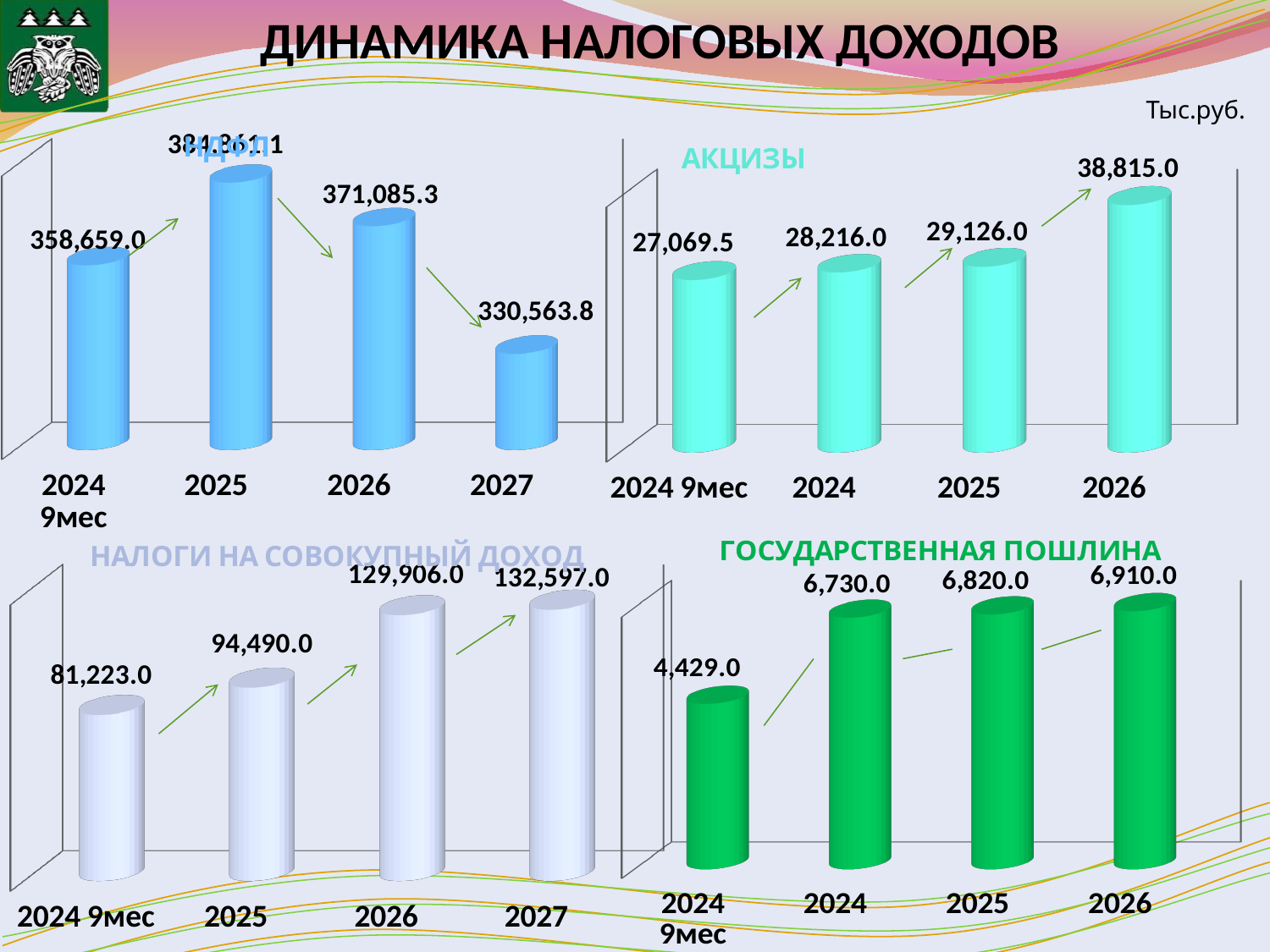
In the АКЦИЗЫ chart, what is the value for 2026? 38,815.0 In the ГОСУДАРСТВЕННАЯ ПОШЛИНА chart, what is the value for 2025? 6,820.0 In the НАЛОГИ НА СОВОКУПНЫЙ ДОХОД chart, what is the value for 2024 9мес? 81,223.0 What kind of chart is the ГОСУДАРСТВЕННАЯ ПОШЛИНА chart? bar chart In the НДФЛ chart, which is larger: the value for 2026 or the value for 2027? 2026 How many bars are in the АКЦИЗЫ chart? 4 In the НАЛОГИ НА СОВОКУПНЫЙ ДОХОД chart, do the values rise or fall from 2024 9мес to 2027? rise In the НАЛОГИ НА СОВОКУПНЫЙ ДОХОД chart, what is the difference between the values for 2026 and 2025? 35,416.0 In the НДФЛ chart, which category has the highest value? 2025 In the ГОСУДАРСТВЕННАЯ ПОШЛИНА chart, what is the difference between the values for 2026 and 2024 9мес? 2,481.0 In the АКЦИЗЫ chart, which category has the lowest value? 2024 9мес In the НДФЛ chart, what is the value for 2027? 330,563.8